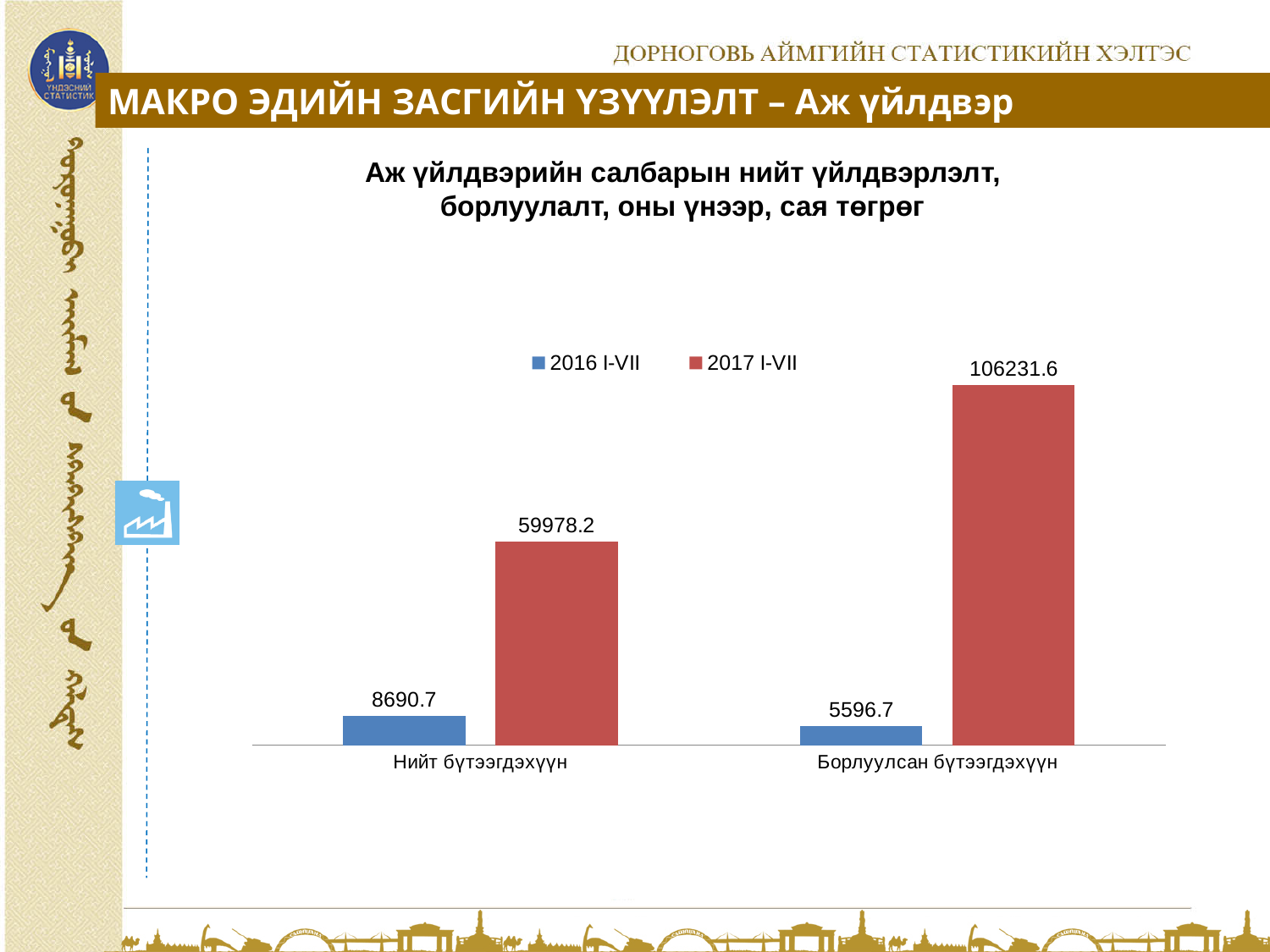
How many series does the legend list? 2 What is the value for Нийт бүтээгдэхүүн in the 2017 I-VII series? 59978.2 What is the difference between the 2017 I-VII and 2016 I-VII values for Борлуулсан бүтээгдэхүүн? 100634.9 Which category has the lowest value in the 2016 I-VII series? Борлуулсан бүтээгдэхүүн What is the value for Борлуулсан бүтээгдэхүүн in the 2016 I-VII series? 5596.7 Which is larger: the 2016 I-VII value for Нийт бүтээгдэхүүн or the 2016 I-VII value for Борлуулсан бүтээгдэхүүн? Нийт бүтээгдэхүүн What is the difference between the 2017 I-VII and 2016 I-VII values for Нийт бүтээгдэхүүн? 51287.5 What is the value for Нийт бүтээгдэхүүн in the 2016 I-VII series? 8690.7 What kind of chart is shown on the slide? Bar chart How many categories are shown on the x axis of the chart? 2 What is the value for Борлуулсан бүтээгдэхүүн in the 2017 I-VII series? 106231.6 Which category has the highest value in the 2017 I-VII series? Борлуулсан бүтээгдэхүүн